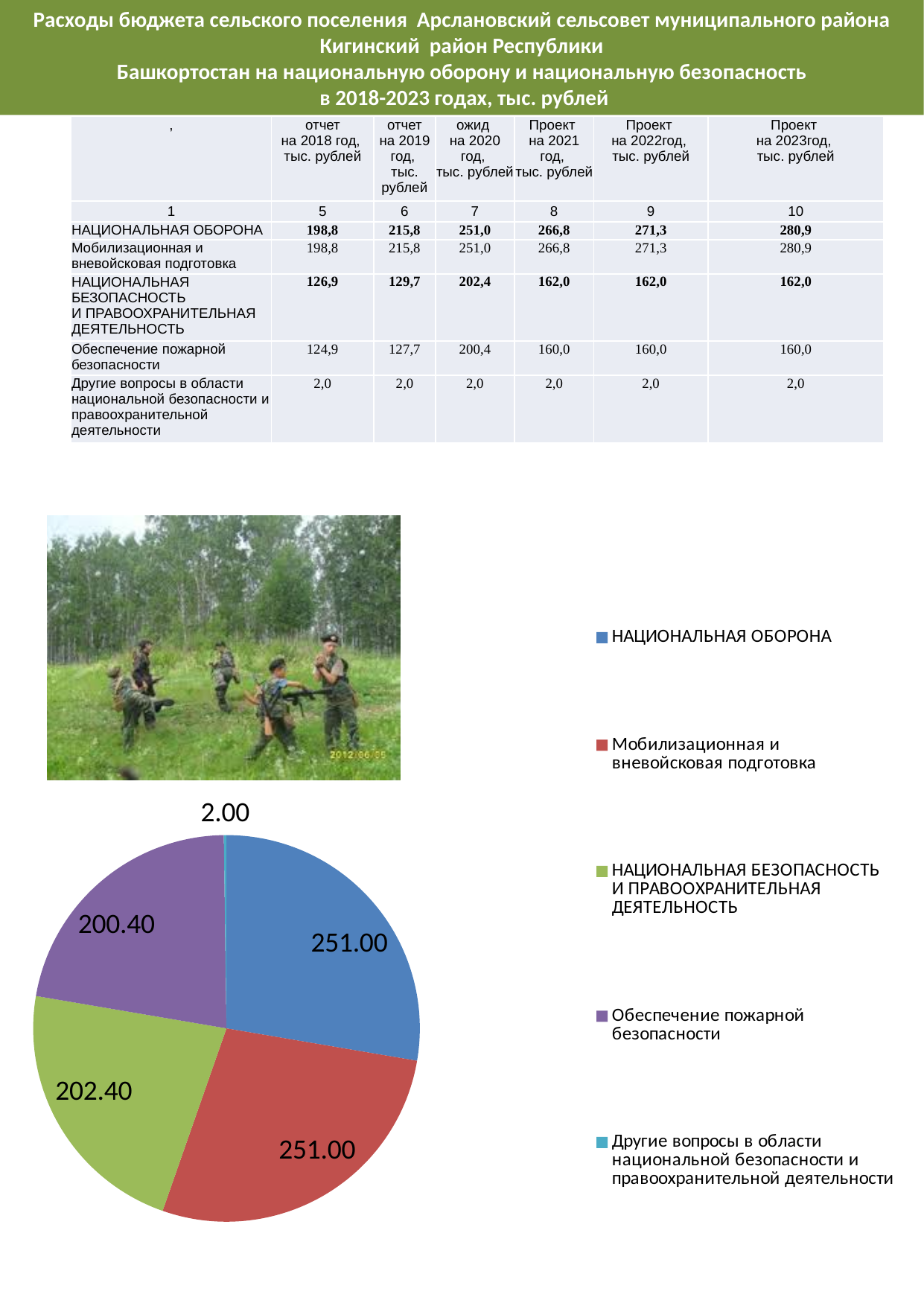
What kind of chart is shown on the slide? pie chart What colour is the Мобилизационная и вневойсковая подготовка slice in the pie chart? red Which slice of the pie chart has the smallest value? Другие вопросы в области национальной безопасности и правоохранительной деятельности How many entries does the legend of the pie chart list? 5 What is the value of the Другие вопросы в области национальной безопасности и правоохранительной деятельности slice in the pie chart? 2.00 What is the value of the Обеспечение пожарной безопасности slice in the pie chart? 200.40 In the pie chart, which is larger: НАЦИОНАЛЬНАЯ ОБОРОНА or Обеспечение пожарной безопасности? НАЦИОНАЛЬНАЯ ОБОРОНА How many slices does the pie chart have? 5 In the pie chart, what is the difference between the НАЦИОНАЛЬНАЯ ОБОРОНА slice and the Обеспечение пожарной безопасности slice? 50.60 What is the value of the НАЦИОНАЛЬНАЯ ОБОРОНА slice in the pie chart? 251.00 In the pie chart, what is the difference between the НАЦИОНАЛЬНАЯ БЕЗОПАСНОСТЬ И ПРАВООХРАНИТЕЛЬНАЯ ДЕЯТЕЛЬНОСТЬ slice and the Обеспечение пожарной безопасности slice? 2.00 What is the value of the НАЦИОНАЛЬНАЯ БЕЗОПАСНОСТЬ И ПРАВООХРАНИТЕЛЬНАЯ ДЕЯТЕЛЬНОСТЬ slice in the pie chart? 202.40